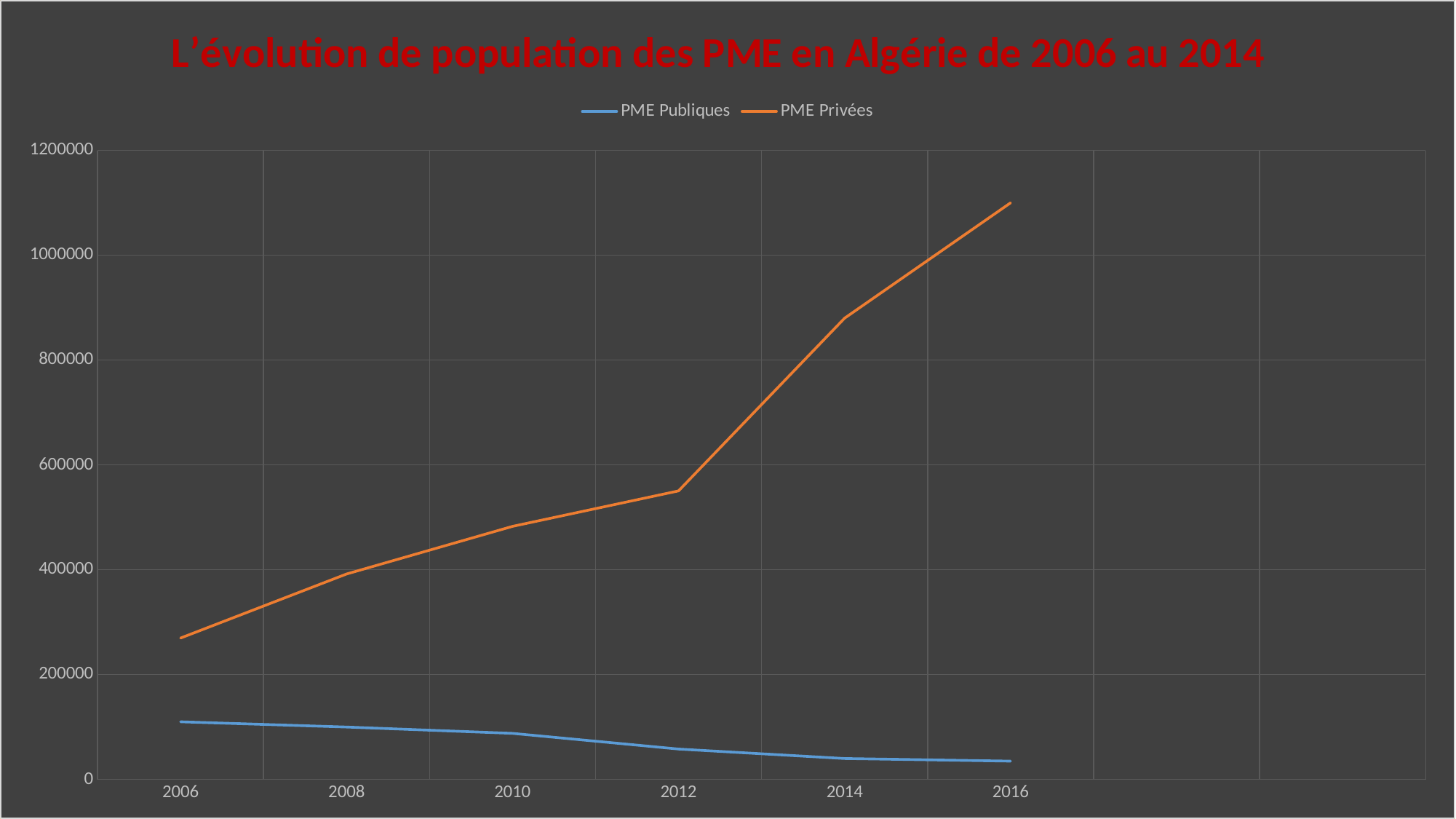
What kind of chart is shown on the slide? line chart In which year is the PME Privées value lowest? 2006 Which colour is used for the PME Privées line? orange Is the PME Publiques value for 2006 greater or less than 200000? less Which series has the larger value in 2012, PME Publiques or PME Privées? PME Privées How many years are labelled on the x axis? 6 In which year is the PME Publiques value highest? 2006 Is the PME Privées value for 2016 greater or less than 1000000? greater Does the PME Privées line rise or fall from 2006 to 2016? rises How many series does the legend list? 2 Does the PME Publiques line rise or fall from 2006 to 2016? falls In which year is the PME Privées value highest? 2016